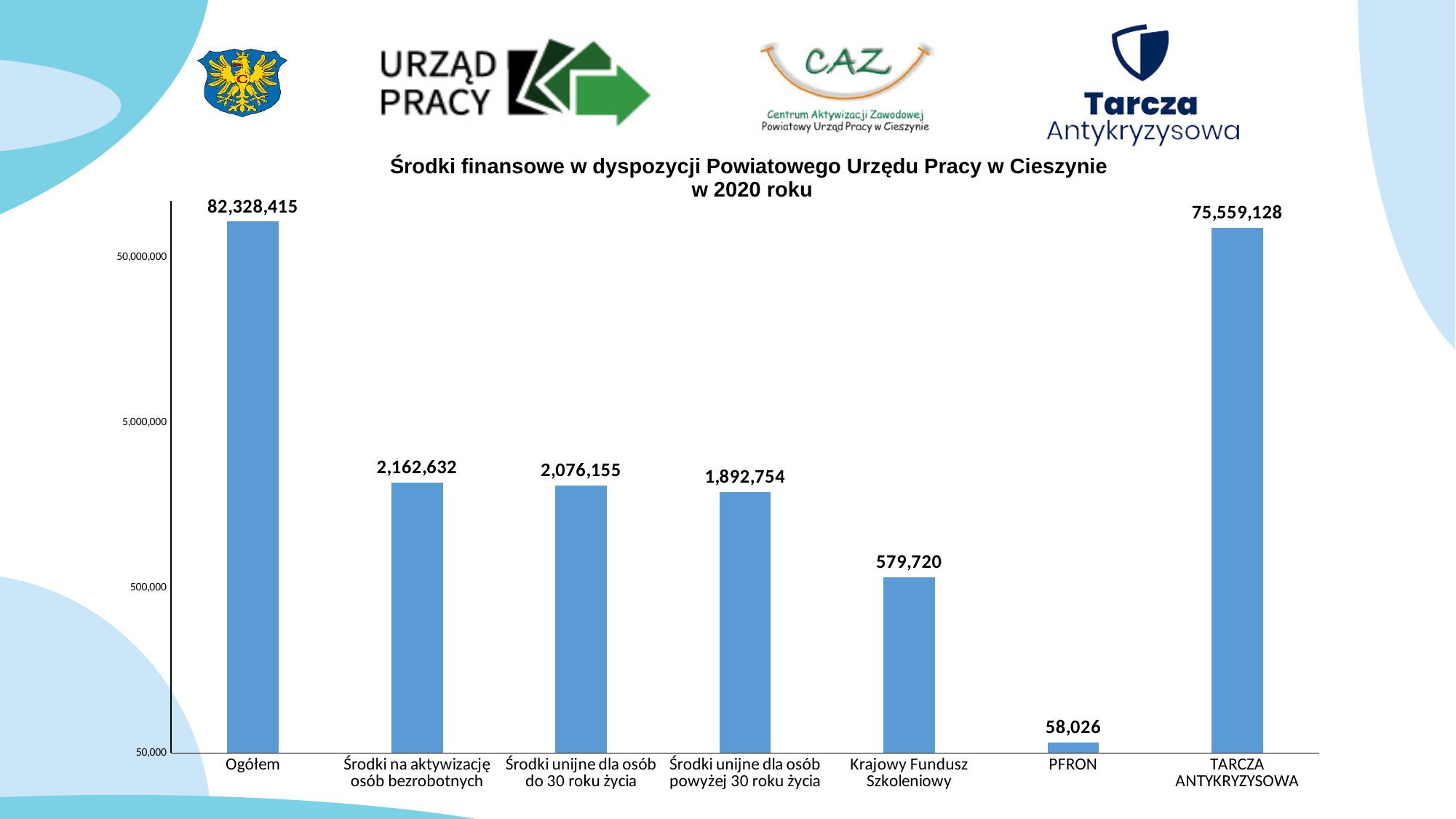
What is the value for Ogółem? 82,328,415 What kind of chart is shown on the slide? bar chart How many categories are shown on the x axis? 7 What is the difference between Ogółem and TARCZA ANTYKRYZYSOWA? 6,769,287 What is the value for TARCZA ANTYKRYZYSOWA? 75,559,128 Which is larger, Krajowy Fundusz Szkoleniowy or PFRON? Krajowy Fundusz Szkoleniowy Which category has the highest value? Ogółem What is the value for PFRON? 58,026 What is the value for Krajowy Fundusz Szkoleniowy? 579,720 What is the difference between Środki unijne dla osób do 30 roku życia and Środki unijne dla osób powyżej 30 roku życia? 183,401 Which category has the lowest value? PFRON Is the value for PFRON greater or less than 500,000? less